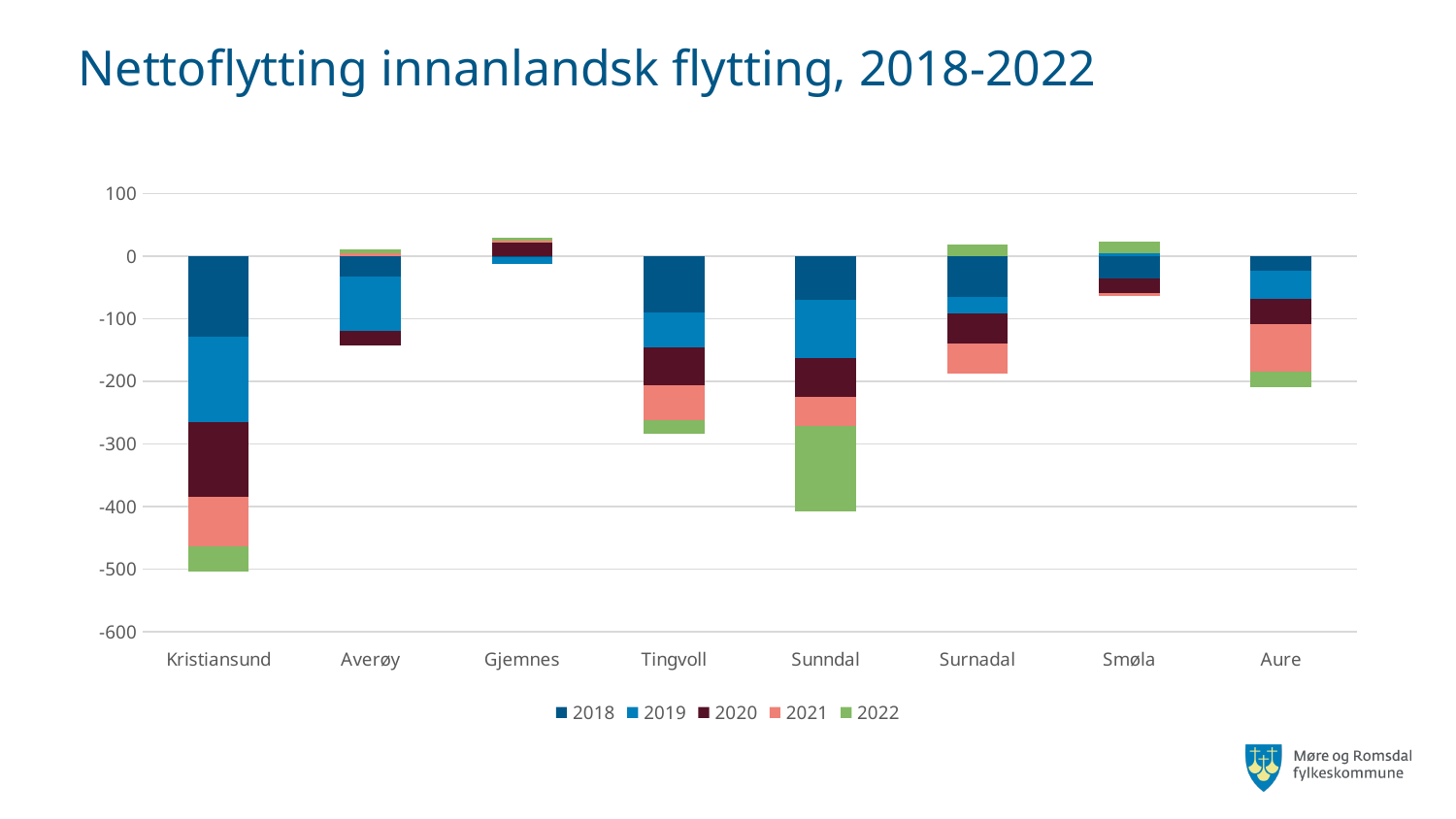
Which municipality has the largest negative 2022 segment? Sunndal What kind of chart is shown on the slide? Stacked bar chart Is the bottom of the stacked bar for Smøla greater or less than -100? greater Is the bottom of the stacked bar for Sunndal greater or less than -300? less How many series does the legend list? 5 Which municipality has the stacked bar that extends furthest below zero? Kristiansund Is the bottom of the stacked bar for Aure greater or less than -100? less Which bar extends further below zero, Kristiansund or Gjemnes? Kristiansund Which years are listed in the legend? 2018, 2019, 2020, 2021, 2022 How many municipalities (categories) are shown on the x axis? 8 What is the title of the chart? Nettoflytting innanlandsk flytting, 2018-2022